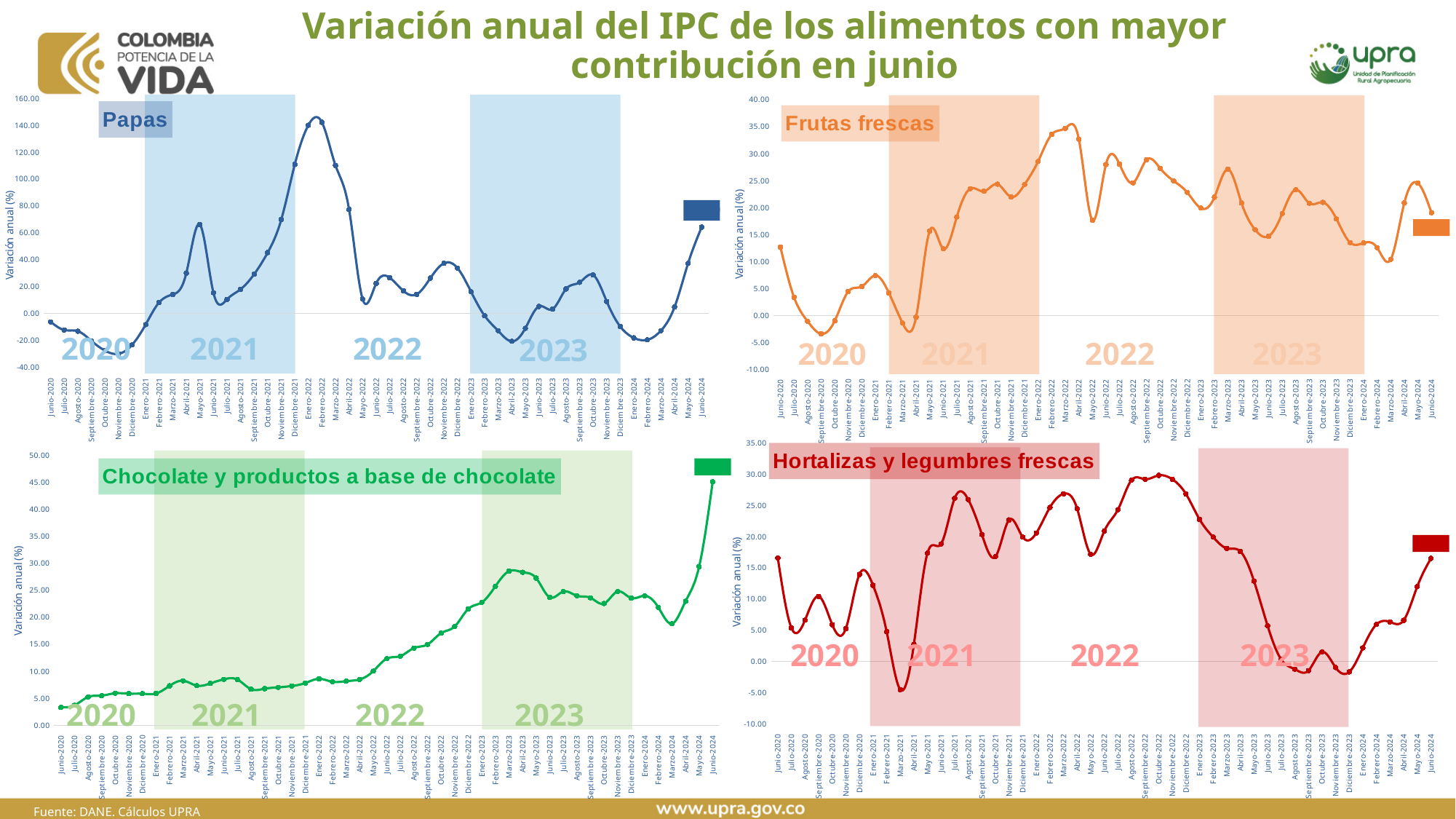
In the Papas chart, which month has the highest value? Febrero-2022 What kind of chart is the Papas chart? line chart In the Chocolate y productos a base de chocolate chart, which month has the lowest value? Junio-2020 How many charts are shown on the slide? 4 In the Hortalizas y legumbres frescas chart, which month has the lowest value? Marzo-2021 In the Papas chart, is the value for Junio-2024 greater or less than 40? greater In the Papas chart, is the value for Febrero-2022 greater or less than 120? greater In the Chocolate y productos a base de chocolate chart, which month has the highest value? Junio-2024 In the Frutas frescas chart, is the value for Marzo-2022 greater or less than 30? greater In the Chocolate y productos a base de chocolate chart, do values generally rise or fall from Junio-2020 to Junio-2024? rise What is the y-axis label on the Hortalizas y legumbres frescas chart? Variación anual (%)